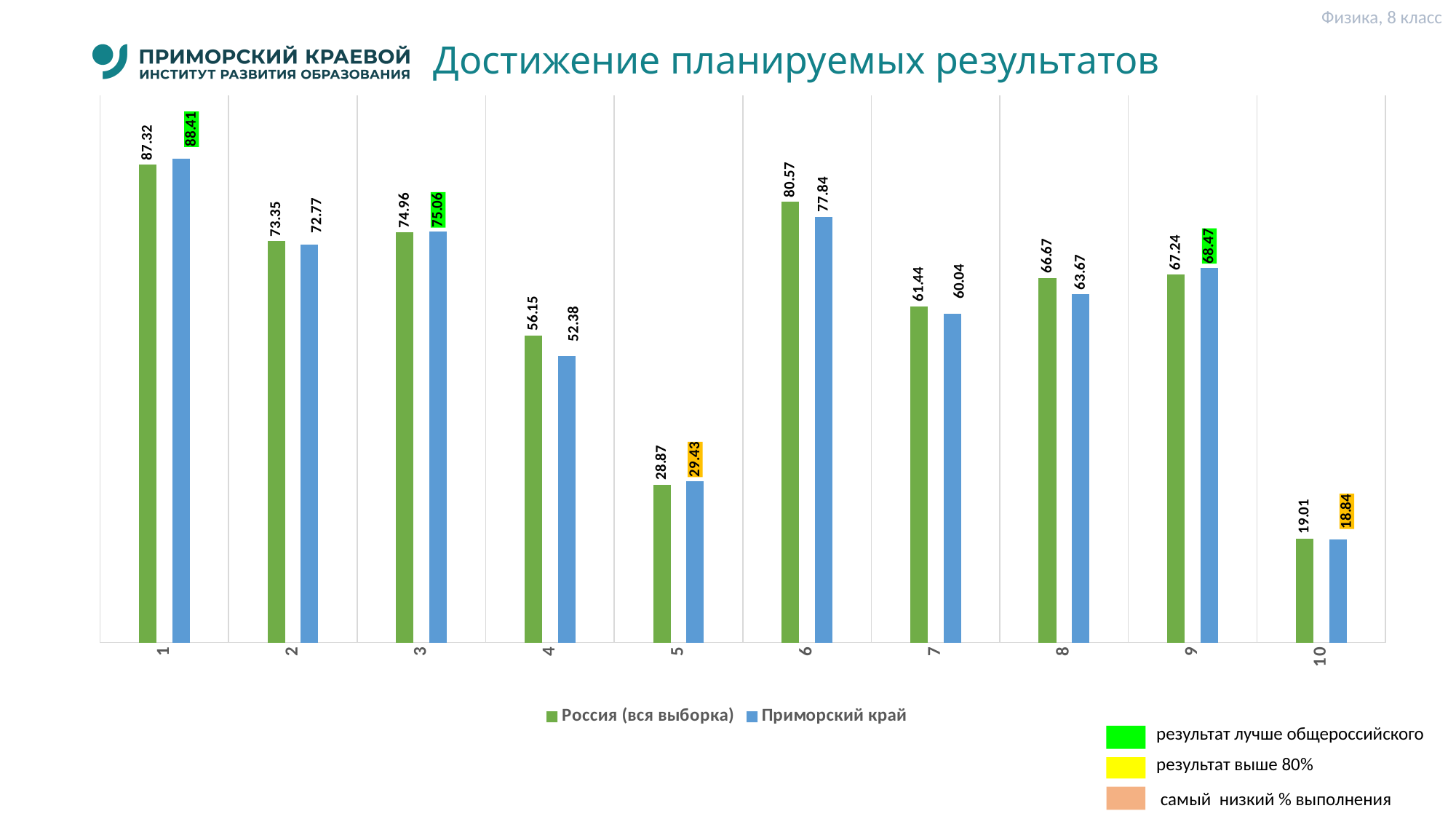
How many categories are shown on the x axis? 10 In category 6, which series has the larger value, Россия (вся выборка) or Приморский край? Россия (вся выборка) What is the title of the chart on the slide? Достижение планируемых результатов What is the difference between Россия (вся выборка) and Приморский край in category 8? 3.00 What is the value for Россия (вся выборка) in category 6? 80.57 What is the value for Приморский край in category 9? 68.47 Which category has the lowest value for Россия (вся выборка)? 10 Which category has the highest value for Приморский край? 1 How many series does the legend list? 2 What kind of chart is shown on the slide? bar chart What is the value for Приморский край in category 4? 52.38 What is the difference between Россия (вся выборка) and Приморский край in category 4? 3.77